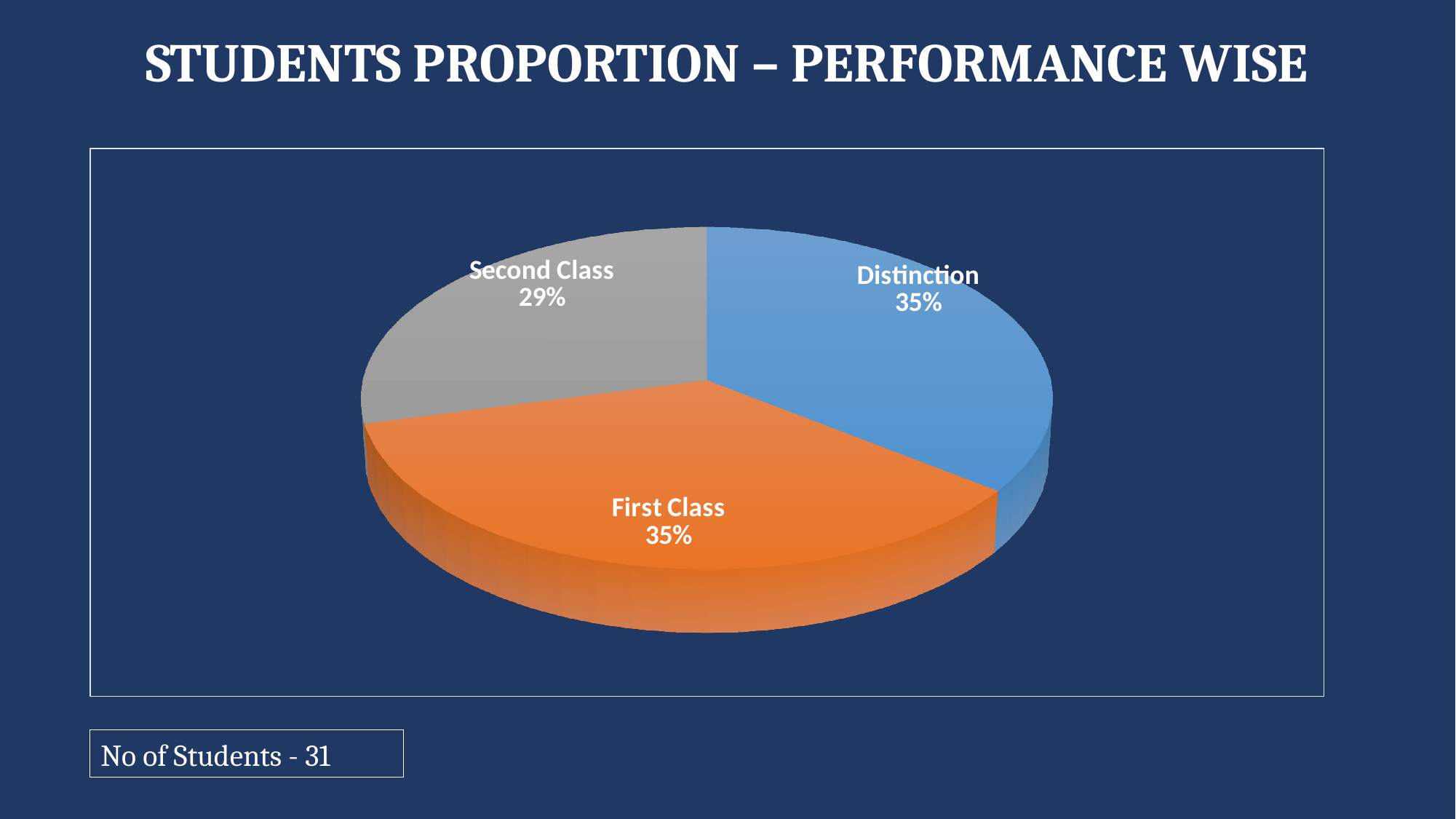
Which is larger, the share for First Class or the share for Second Class? First Class What colour is the First Class slice? Orange What percentage of students are in the Distinction category? 35% What percentage of students are in the Second Class category? 29% How many categories does the pie chart show? 3 What kind of chart is shown on the slide? Pie chart What is the title of the slide containing the pie chart? STUDENTS PROPORTION – PERFORMANCE WISE What percentage of students are in the First Class category? 35% What is the difference in percentage points between the Distinction and Second Class shares? 6 Which category has the smallest share of the pie? Second Class What is the total number of students stated on the slide? 31